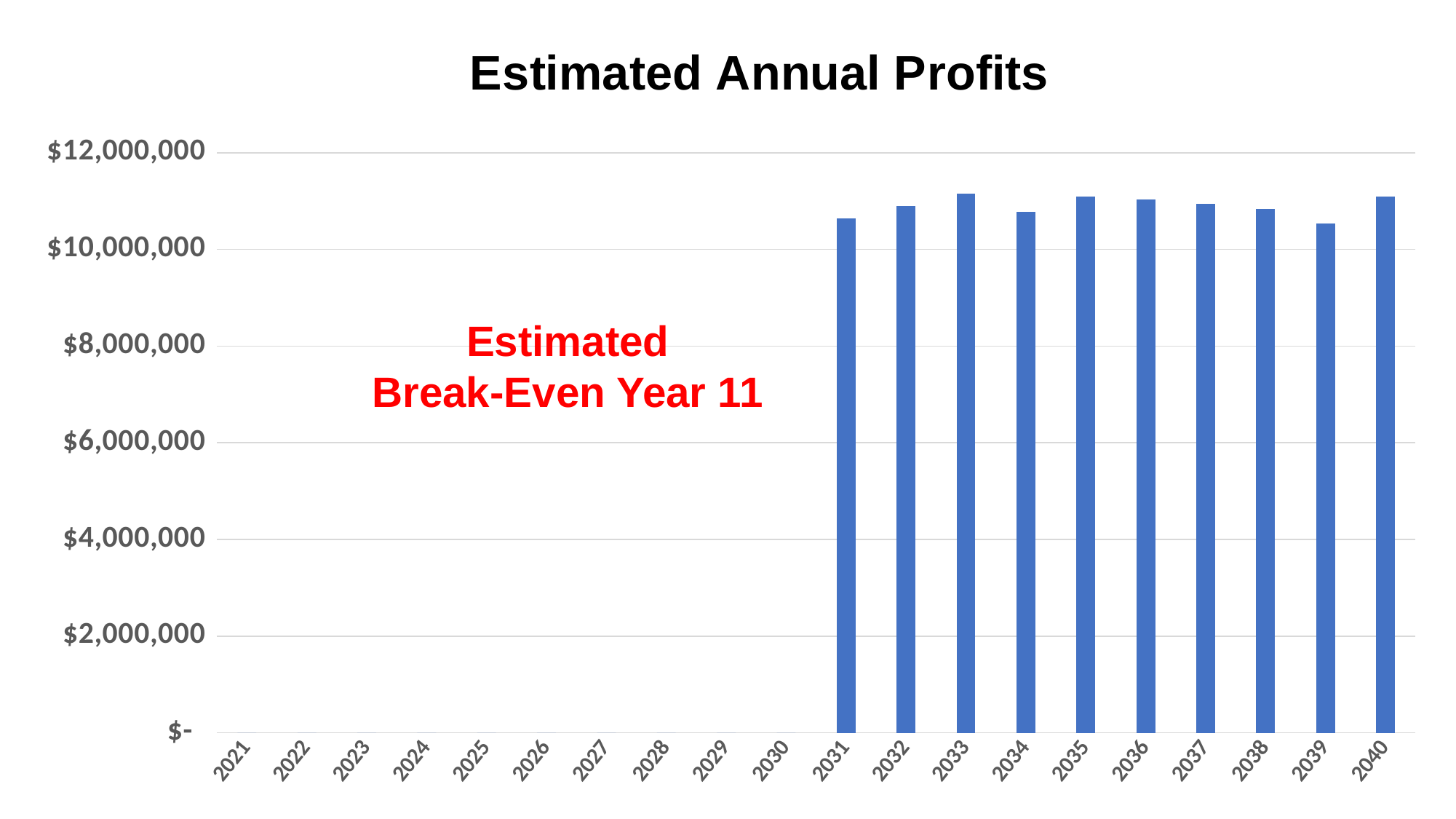
What does the red text on the chart say? Estimated Break-Even Year 11 Is the value for 2031 greater or less than $10,000,000? greater Which is the first year with a visible bar? 2031 What kind of chart is shown on the slide? bar chart Which year has the lowest bar among the years with bars? 2039 Is the value for 2033 greater or less than $12,000,000? less How many years have a visible bar on the chart? 10 How many years are labelled on the x axis? 20 What is the title of the chart? Estimated Annual Profits Which is larger, the value for 2031 or the value for 2035? 2035 Which is larger, the value for 2033 or the value for 2039? 2033 Is the value for 2039 greater or less than $10,000,000? greater